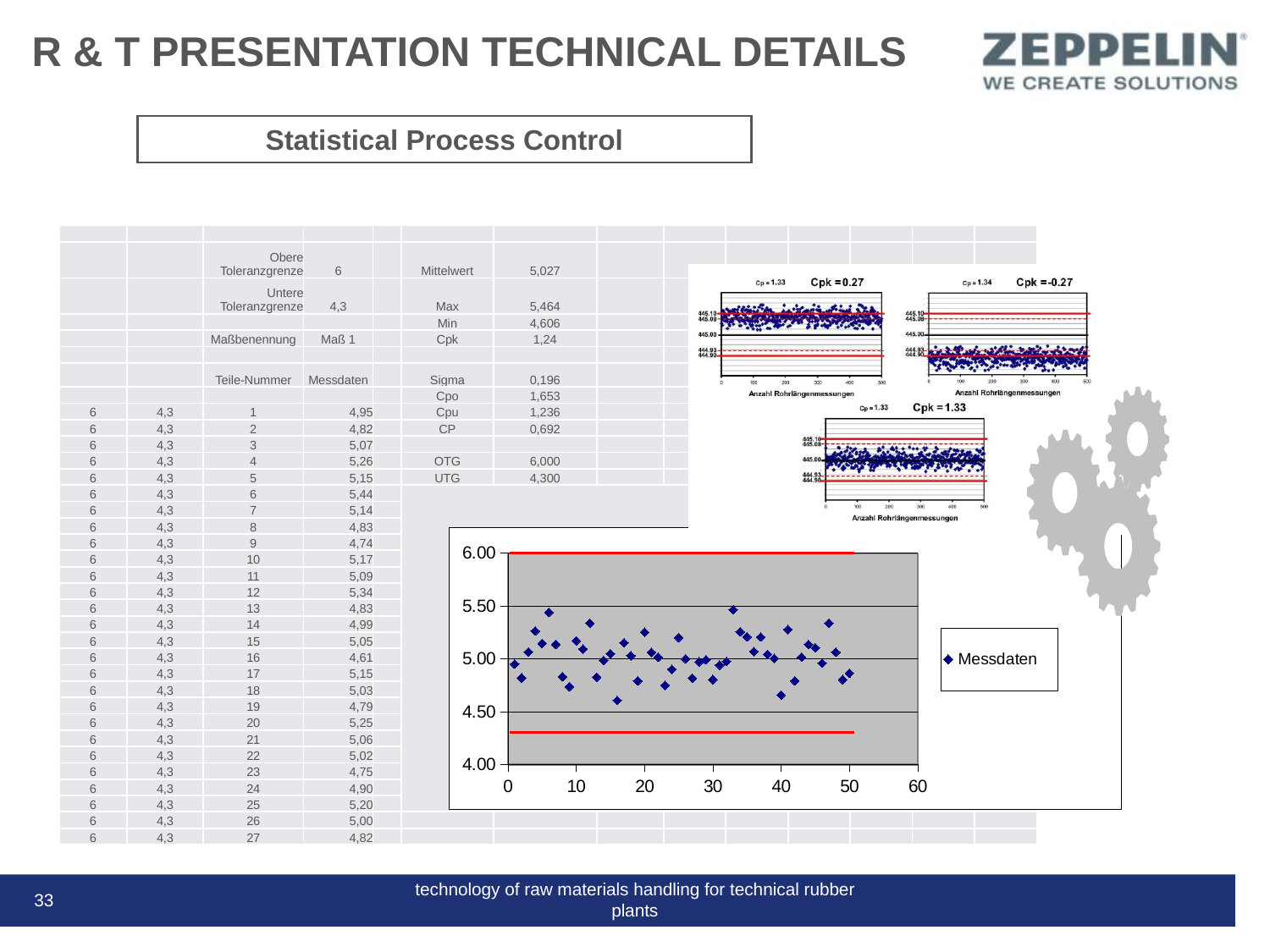
Is the lowest plotted point in the chart greater or less than 4.00? greater Do the plotted values show a clear rising or falling trend along the x axis? no Is the highest plotted point in the chart greater or less than 6.00? less What is the name of the series shown in the chart legend? Messdaten What kind of chart is shown on the slide? scatter chart How many series does the chart legend list? 1 What is the highest value shown on the chart's y axis? 6.00